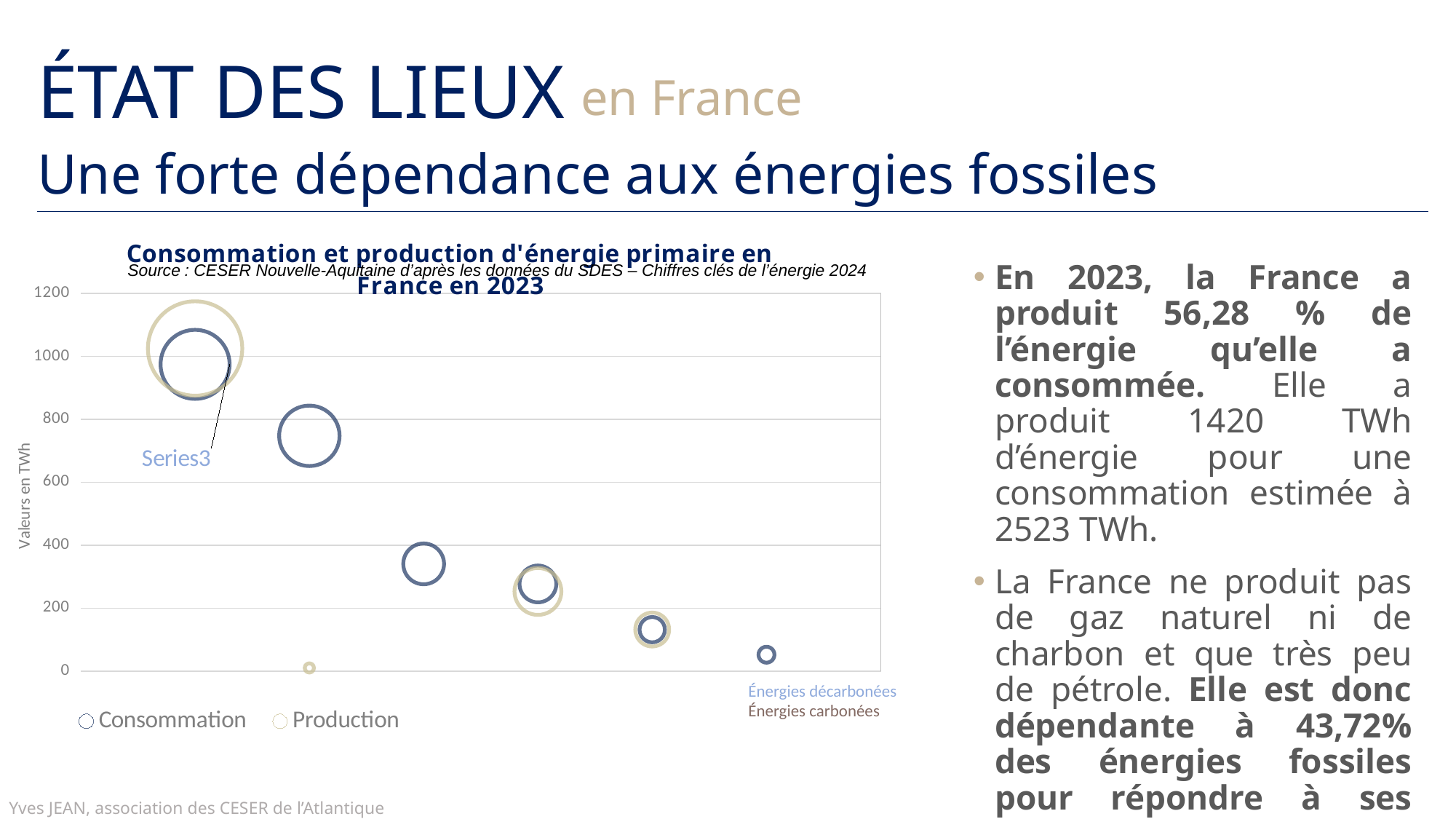
Is the value of the highest Consommation bubble greater or less than 800? greater Is the value of the second Consommation bubble from the left greater or less than 600? greater What is the title of the chart? Consommation et production d'énergie primaire en France en 2023 What are the two series named in the chart legend? Consommation and Production What is the highest tick value shown on the chart's vertical axis? 1200 How many Consommation bubbles are plotted on the chart? 6 How many series does the chart legend list? 2 Is the value of the lowest Production bubble greater or less than 200? less What kind of chart is shown on the slide? Bubble chart Do the Consommation values rise or fall from left to right along the x axis? Fall